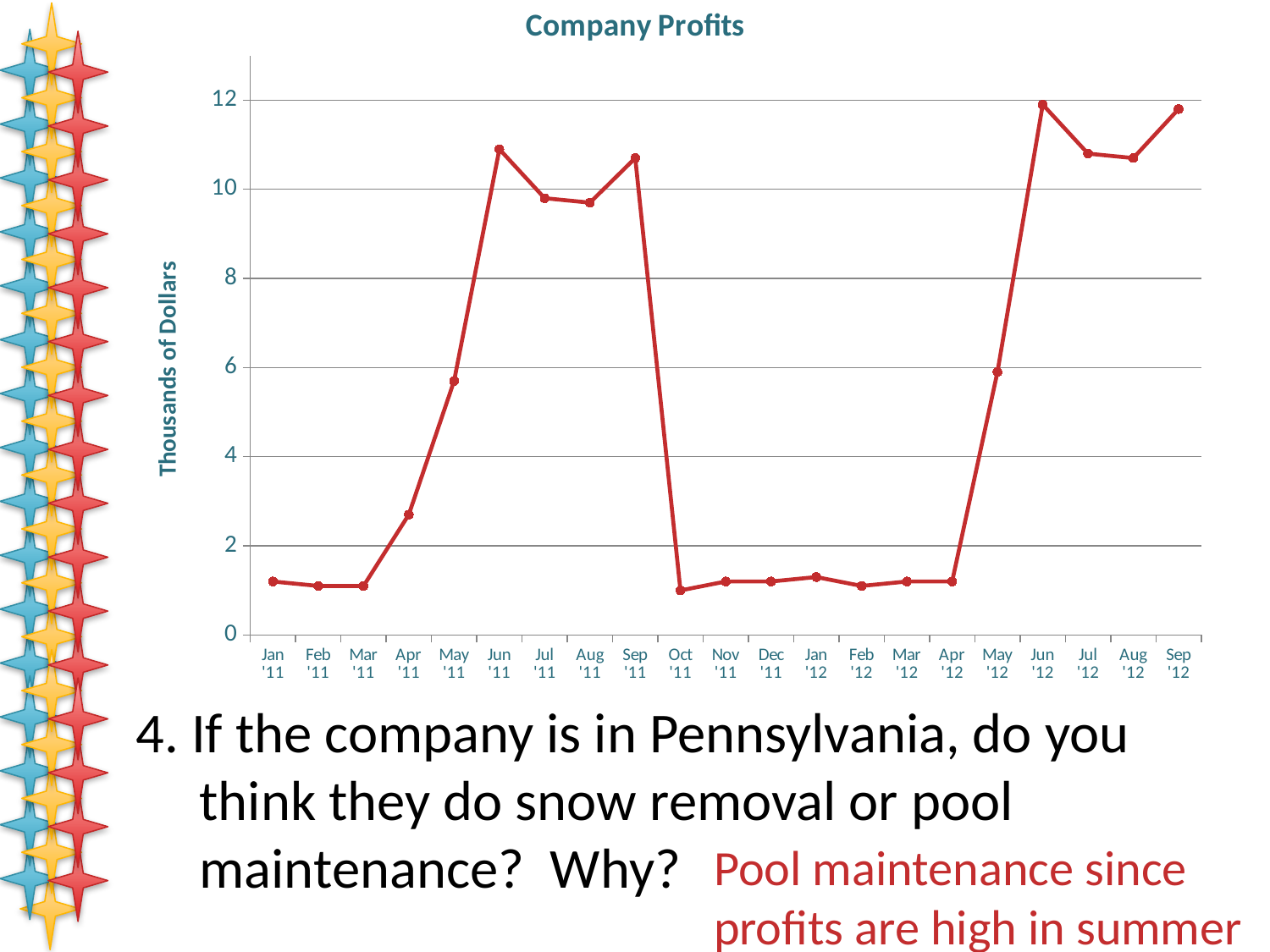
What kind of chart is shown on the slide? line chart How many months are plotted along the x axis of the chart? 21 Is the value for Jun '12 greater or less than 10? greater Which is larger, the value for Jun '11 or the value for Jan '11? Jun '11 Do the values rise or fall from Jan '11 to Jun '11? rise Do the values rise or fall from Sep '11 to Oct '11? fall What is the label on the vertical axis of the chart? Thousands of Dollars What is the title of the chart? Company Profits Is the value for Apr '11 greater or less than 2? greater Is the value for Oct '11 greater or less than 2? less